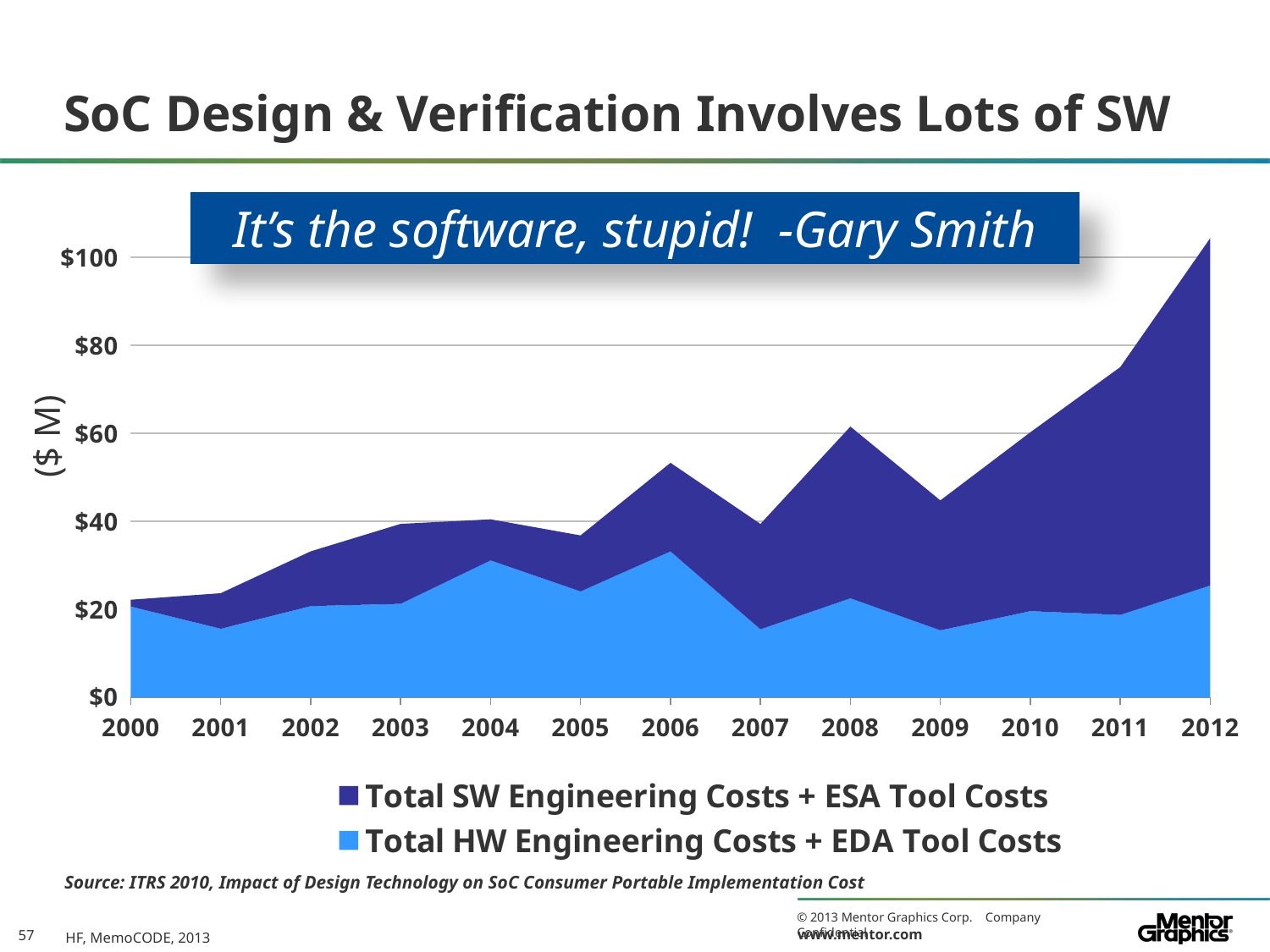
Which is larger: the total cost in 2012 or the total cost in 2000? 2012 How many years are plotted along the x axis of the chart? 13 Is the total cost for 2000 greater or less than $40? less Is the value for Total HW Engineering Costs + EDA Tool Costs in 2004 greater or less than $20? greater What kind of chart is shown on the slide? Stacked area chart Which year has the highest total cost in the chart? 2012 How many series does the chart's legend list? 2 Is the total cost for 2011 greater or less than $80? less Does the total cost generally rise or fall from 2000 to 2012? Rise What is the label on the y axis of the chart? ($ M)